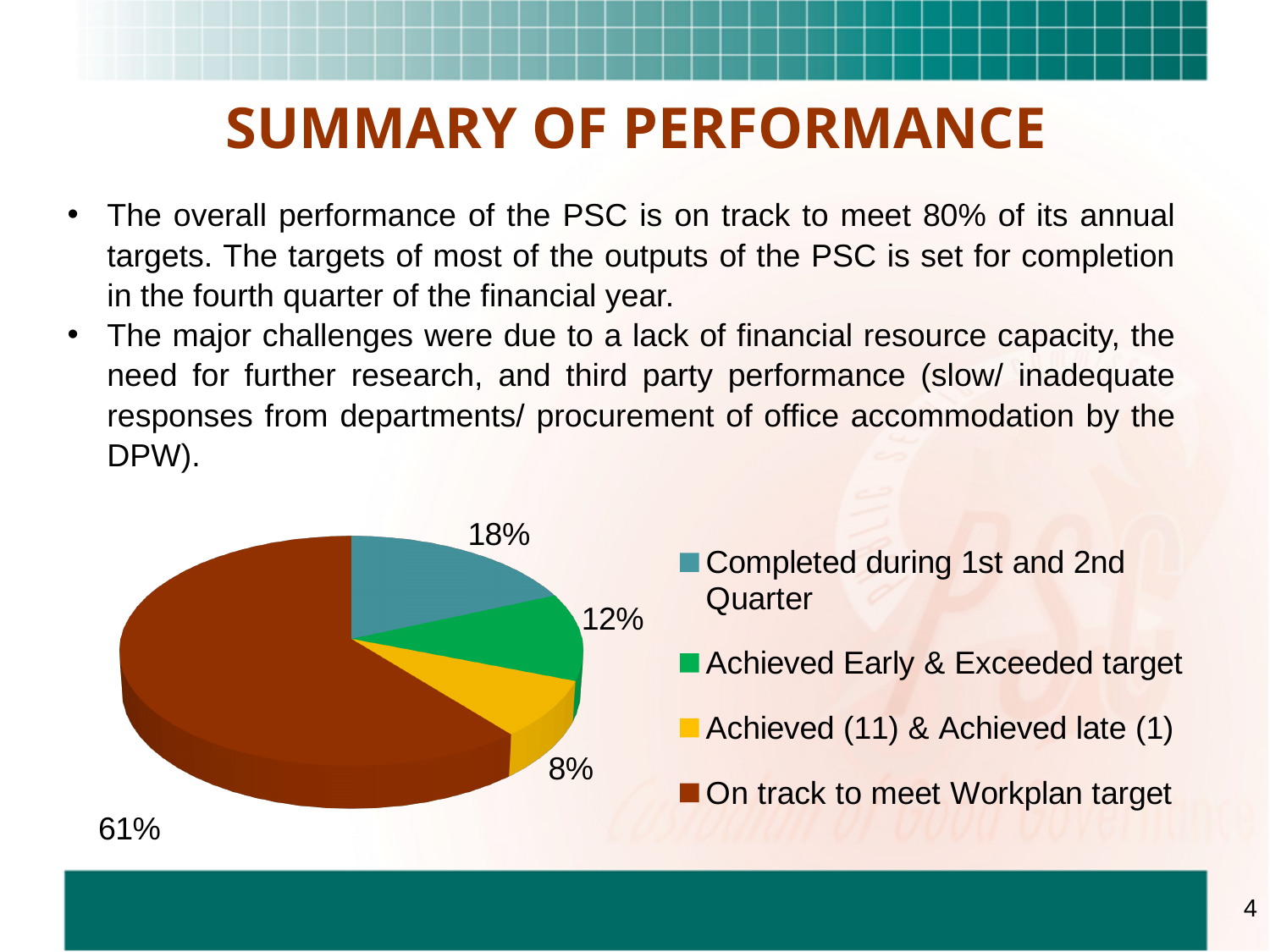
Which category has the largest slice of the pie? On track to meet Workplan target What colour is the slice for 'On track to meet Workplan target'? Brown How many slices does the pie chart have? 4 What percentage of the pie is labelled 'On track to meet Workplan target'? 61% What percentage of the pie is labelled 'Achieved (11) & Achieved late (1)'? 8% How many entries does the legend list? 4 What percentage of the pie is labelled 'Completed during 1st and 2nd Quarter'? 18% Which category has the smallest slice of the pie? Achieved (11) & Achieved late (1) What percentage of the pie is labelled 'Achieved Early & Exceeded target'? 12% Which is larger: the slice for 'Achieved Early & Exceeded target' or the slice for 'Achieved (11) & Achieved late (1)'? Achieved Early & Exceeded target What is the difference in percentage points between 'On track to meet Workplan target' and 'Completed during 1st and 2nd Quarter'? 43 What kind of chart is shown on the slide? Pie chart